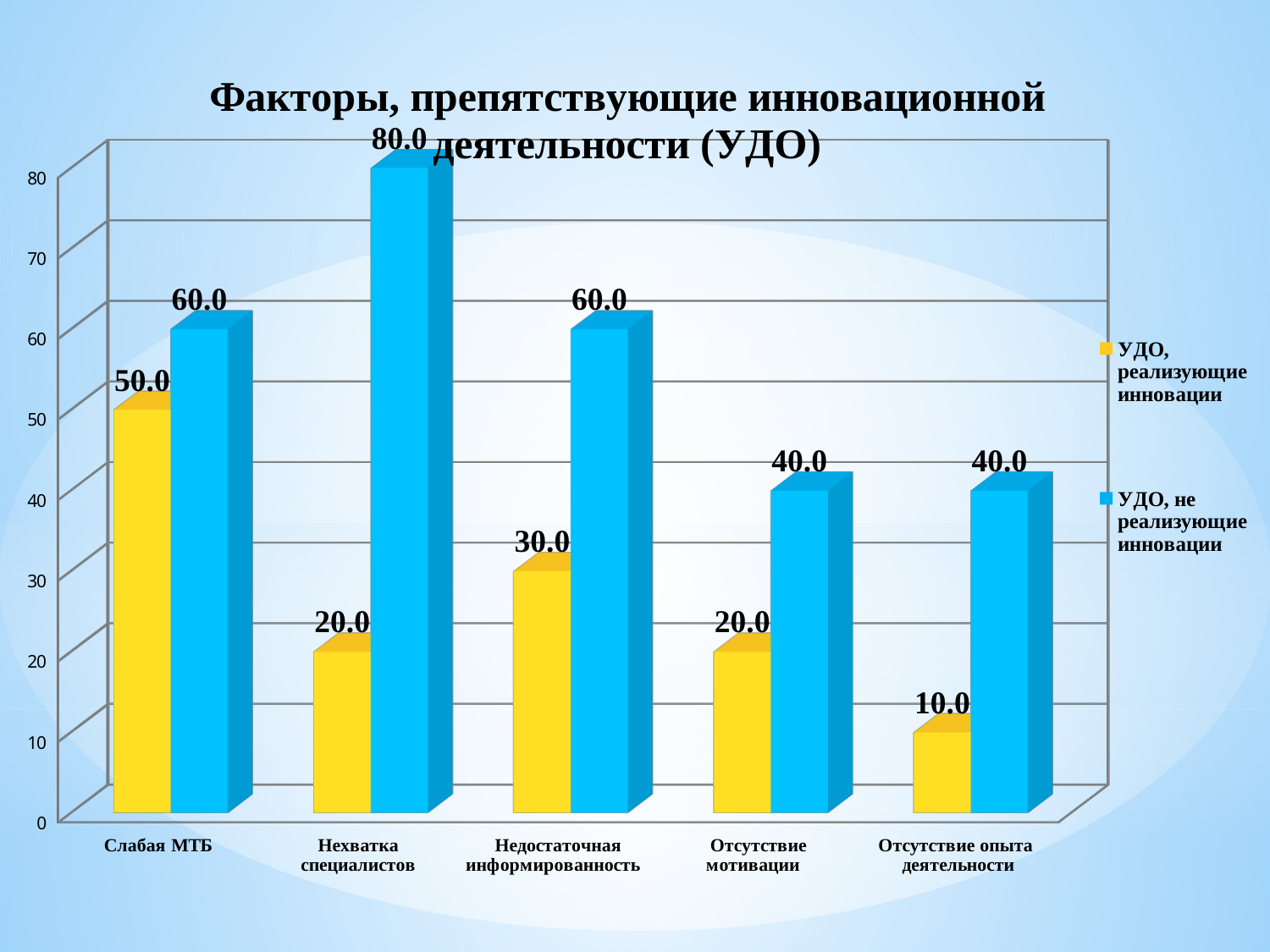
What kind of chart is shown on the slide? Bar chart Which colour represents the 'УДО, реализующие инновации' series? Yellow Which category has the highest value in the 'УДО, не реализующие инновации' series? Нехватка специалистов What is the difference between the two series for 'Нехватка специалистов'? 60.0 What is the title of the chart? Факторы, препятствующие инновационной деятельности (УДО) How many categories are shown on the x axis? 5 What is the value for 'Нехватка специалистов' in the 'УДО, не реализующие инновации' series? 80.0 What is the value for 'Слабая МТБ' in the 'УДО, реализующие инновации' series? 50.0 What is the value for 'Отсутствие опыта деятельности' in the 'УДО, реализующие инновации' series? 10.0 For 'Недостаточная информированность', which series has the larger value? УДО, не реализующие инновации How many series does the legend list? 2 Which category has the lowest value in the 'УДО, реализующие инновации' series? Отсутствие опыта деятельности